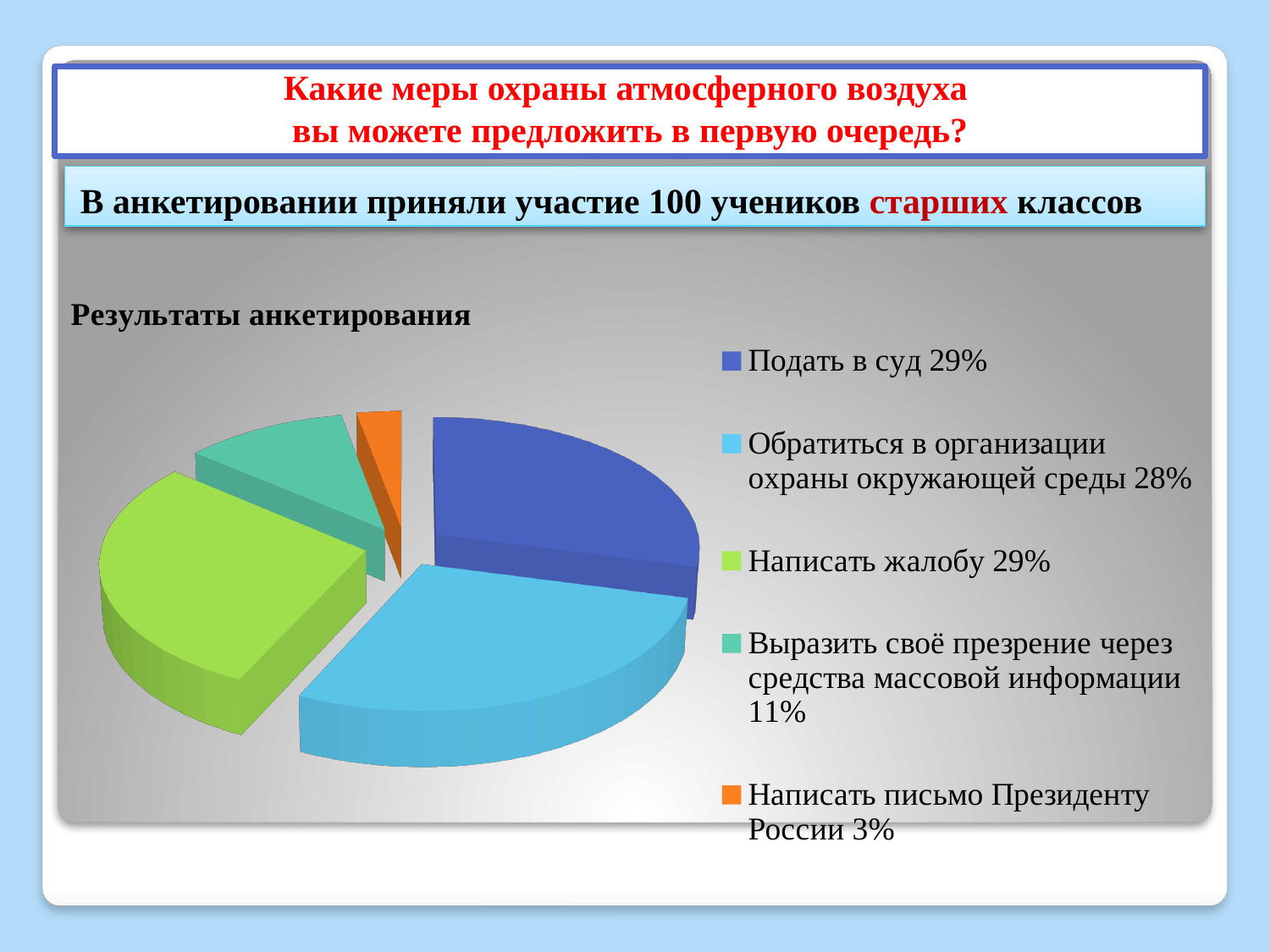
What is the title of the chart? Результаты анкетирования What kind of chart is shown on the slide? pie chart Which is larger: the share for "Обратиться в организации охраны окружающей среды" or for "Выразить своё презрение через средства массовой информации"? Обратиться в организации охраны окружающей среды How many categories does the pie chart have? 5 What percentage of respondents chose "Обратиться в организации охраны окружающей среды"? 28% What percentage of respondents chose "Подать в суд"? 29% What percentage of respondents chose "Написать жалобу"? 29% What colour is the slice for "Написать письмо Президенту России"? orange What is the difference between the shares for "Обратиться в организации охраны окружающей среды" and "Написать письмо Президенту России"? 25% What share of the pie does "Выразить своё презрение через средства массовой информации" take? 11% What is the difference between the shares for "Написать жалобу" and "Выразить своё презрение через средства массовой информации"? 18% Which category has the smallest share of the pie? Написать письмо Президенту России